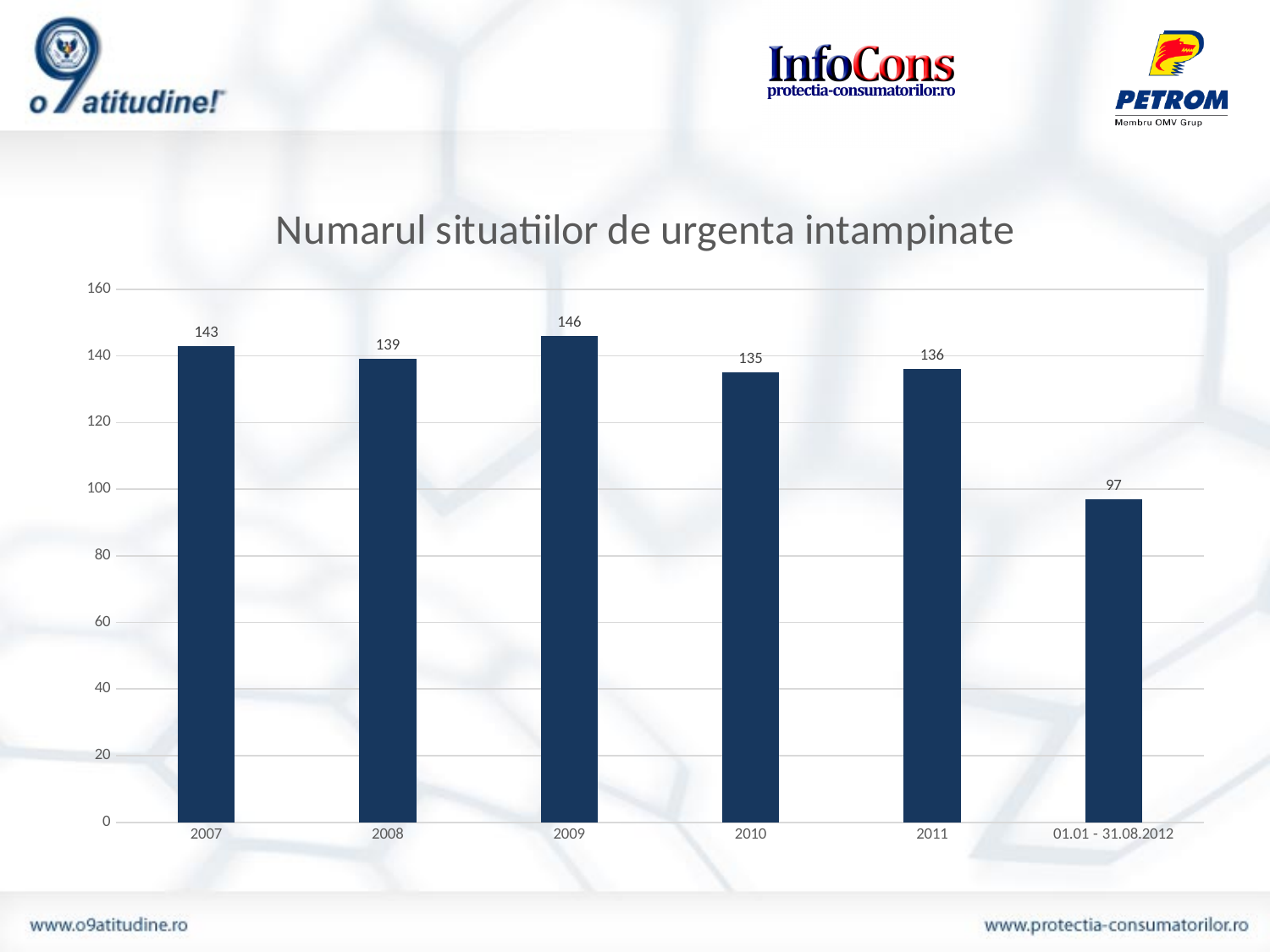
What is the value for 01.01 - 31.08.2012? 97 Which is larger, the value for 2010 or the value for 2011? 2011 How many categories are shown on the x axis? 6 What is the difference between the values for 2007 and 2008? 4 What is the difference between the values for 2009 and 01.01 - 31.08.2012? 49 Which year has the highest value? 2009 What is the title of the chart? Numarul situatiilor de urgenta intampinate Which category has the lowest value? 01.01 - 31.08.2012 What is the value for 2009? 146 What kind of chart is shown? bar chart What is the value for 2010? 135 Is the value for 2008 greater or less than 120? greater